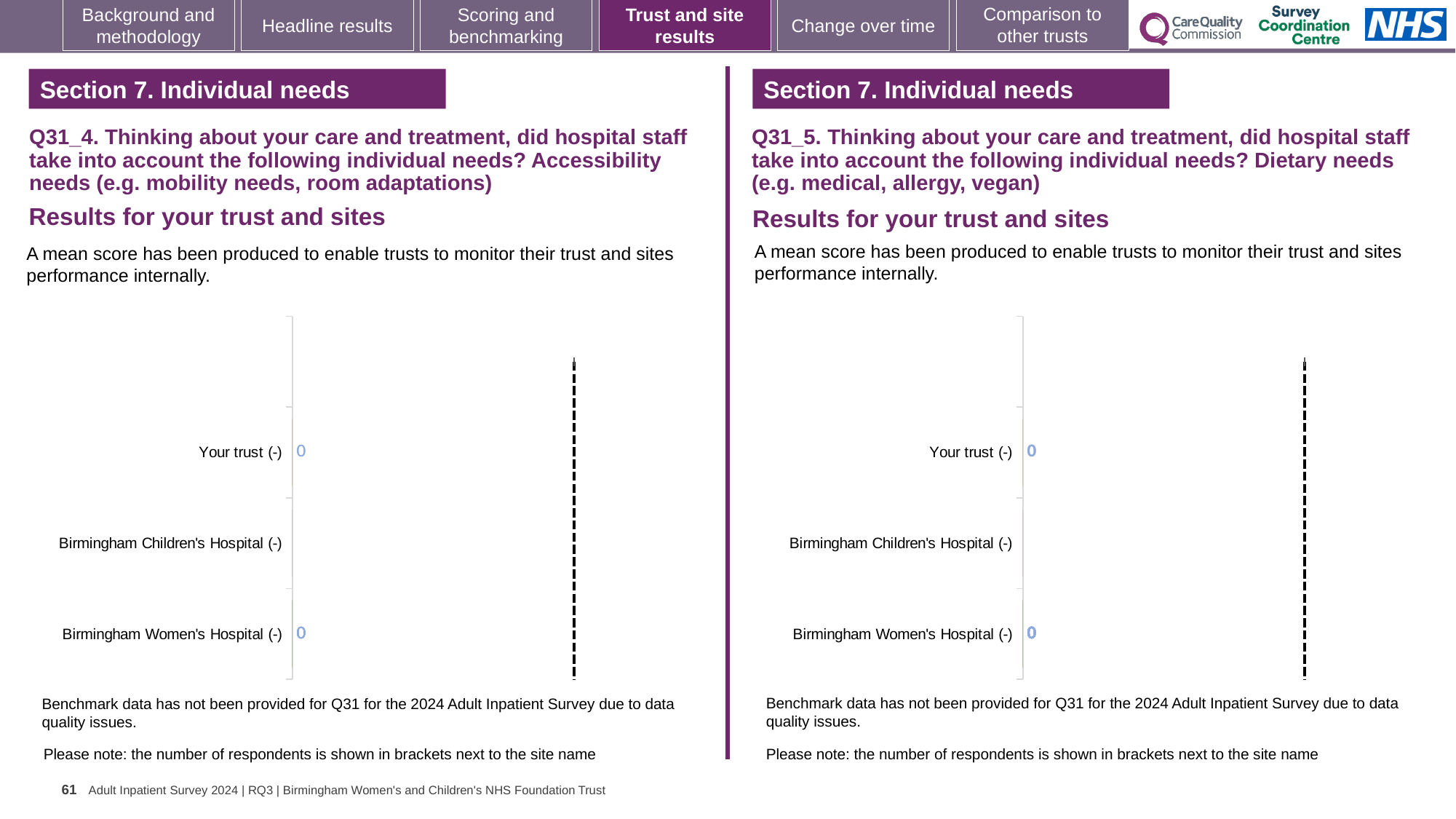
In the right chart (Q31_5, Dietary needs), which category is listed at the bottom of the vertical axis? Birmingham Women's Hospital (-) What kind of chart is the right chart (Q31_5, Dietary needs)? bar chart In the left chart (Q31_4, Accessibility needs), what value is printed for Your trust (-)? 0 What kind of chart is the left chart (Q31_4, Accessibility needs)? bar chart How many charts are shown on the slide? 2 In the left chart (Q31_4, Accessibility needs), which category is listed at the top of the vertical axis? Your trust (-) In the right chart (Q31_5, Dietary needs), what value is printed for Your trust (-)? 0 In the right chart (Q31_5, Dietary needs), what value is printed for Birmingham Women's Hospital (-)? 0 In the left chart (Q31_4, Accessibility needs), how many categories are listed on the vertical axis? 3 In the right chart (Q31_5, Dietary needs), how many categories are listed on the vertical axis? 3 In the left chart (Q31_4, Accessibility needs), what value is printed for Birmingham Women's Hospital (-)? 0